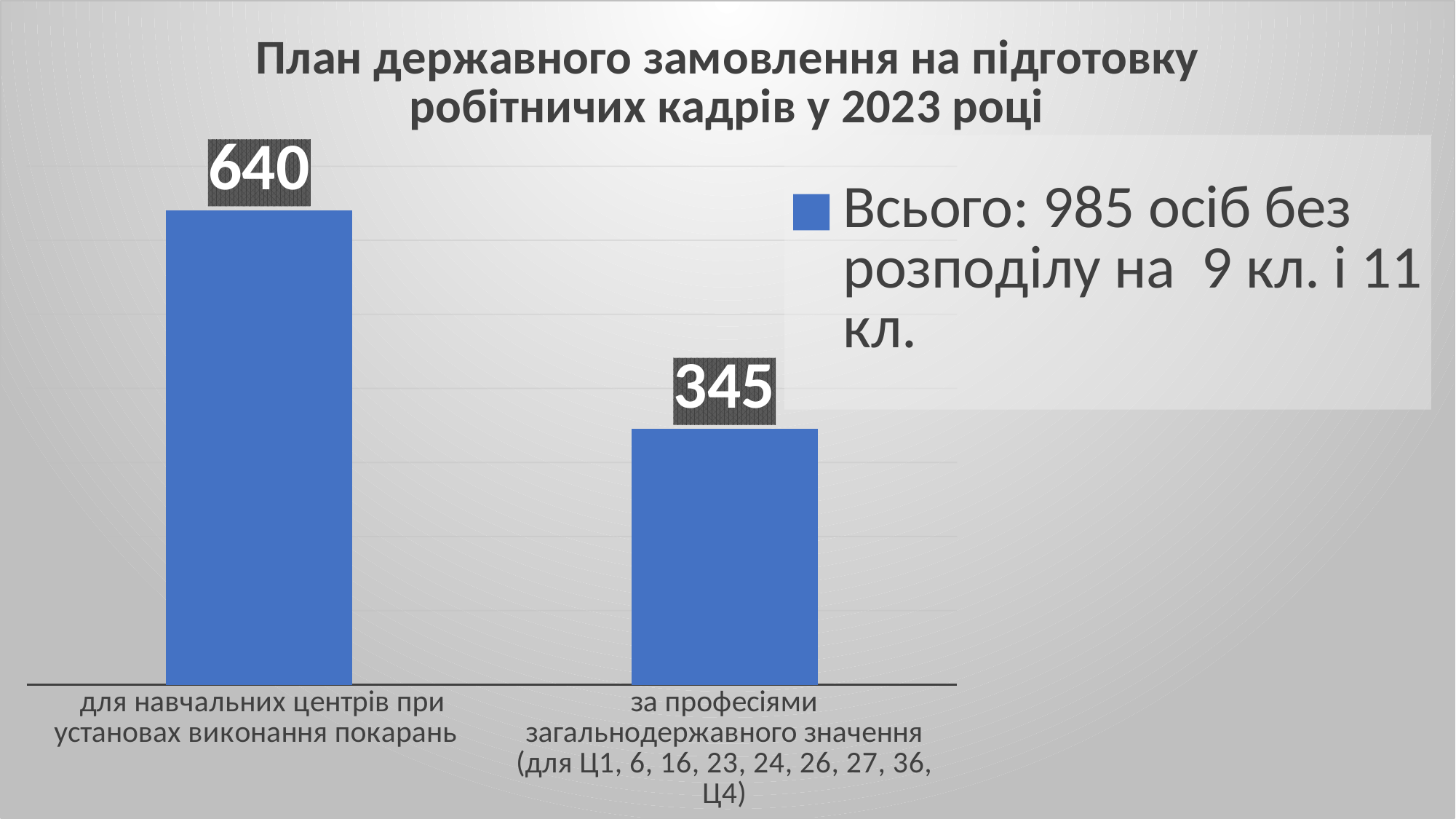
How many categories are shown in the chart? 2 What is the value for "за професіями загальнодержавного значення"? 345 Which is larger: the value for "для навчальних центрів при установах виконання покарань" or for "за професіями загальнодержавного значення"? для навчальних центрів при установах виконання покарань Which category has the lowest value? за професіями загальнодержавного значення What is the sum of the two bar values shown in the chart? 985 Which category has the highest value? для навчальних центрів при установах виконання покарань What is the value for "для навчальних центрів при установах виконання покарань"? 640 How many series does the legend list? 1 What is the difference between the value for "для навчальних центрів при установах виконання покарань" and the value for "за професіями загальнодержавного значення"? 295 What is the title of the chart? План державного замовлення на підготовку робітничих кадрів у 2023 році What kind of chart is shown on the slide? bar chart What is the legend entry shown on the chart? Всього: 985 осіб без розподілу на 9 кл. і 11 кл.